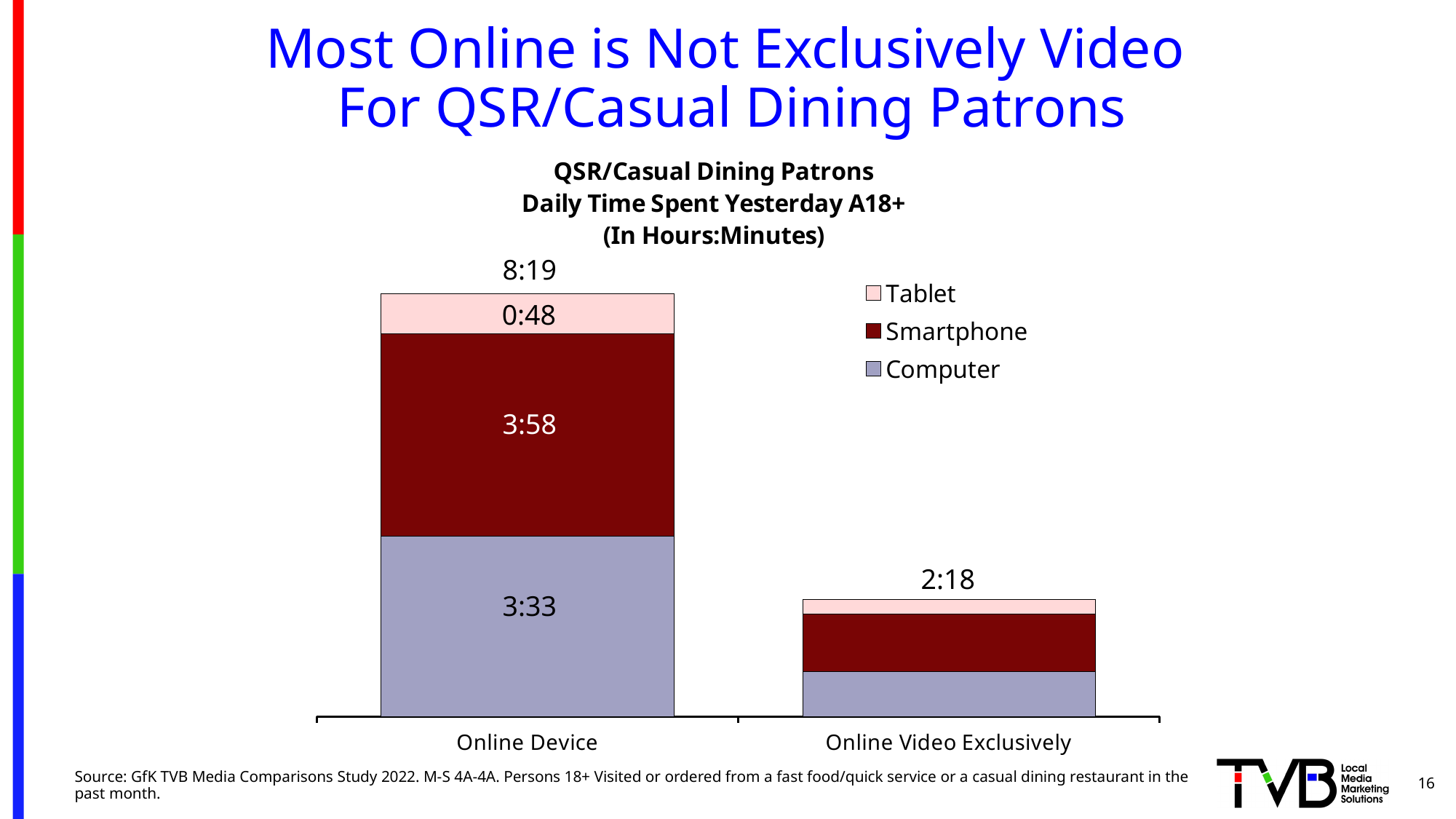
What is the total daily time spent for Online Device? 8:19 What kind of chart is shown on the slide? Stacked bar chart How much time is shown for Smartphone in the Online Device bar? 3:58 Within the Online Device bar, which device has the smallest time? Tablet What is the total daily time spent for Online Video Exclusively? 2:18 Which category has the larger total daily time spent, Online Device or Online Video Exclusively? Online Device How many series does the legend list? 3 What is the difference between the Online Device total and the Online Video Exclusively total? 6:01 How much time is shown for Computer in the Online Device bar? 3:33 How much time is shown for Tablet in the Online Device bar? 0:48 Within the Online Device bar, which is larger, Smartphone or Computer? Smartphone How many categories are shown on the x axis? 2